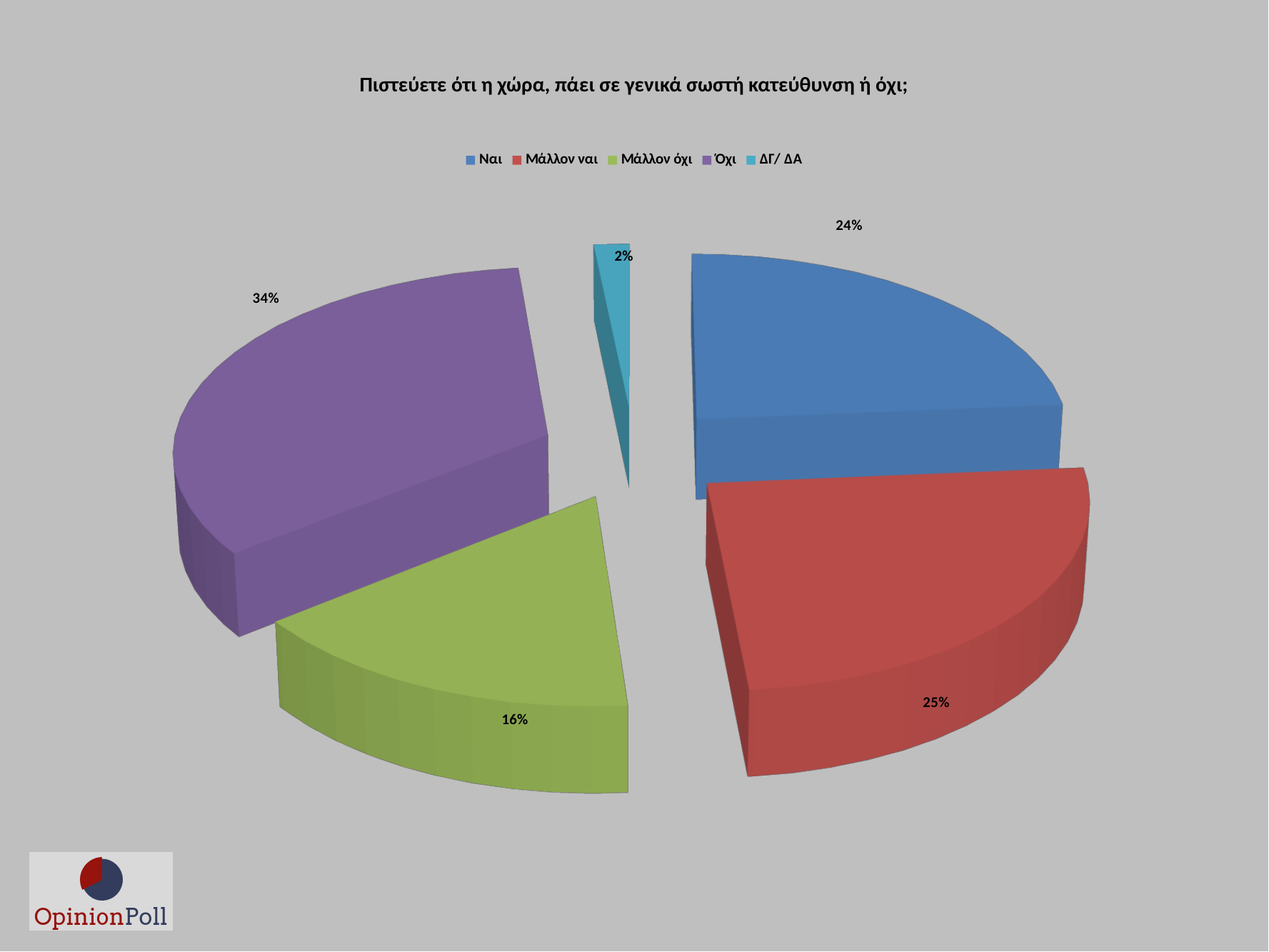
What percentage of the pie is labelled for Ναι? 24% What percentage is shown for Μάλλον ναι? 25% Which is larger, the share for Μάλλον όχι or the share for Ναι? Ναι What is the difference in percentage points between Όχι and Ναι? 10 Which category has the smallest share of the pie? ΔΓ/ ΔΑ What kind of chart is shown on the slide? Pie chart What percentage is shown for Μάλλον όχι? 16% How many categories does the pie chart show? 5 What percentage is shown for Όχι? 34% What colour is the slice for Όχι? Purple What percentage is shown for ΔΓ/ ΔΑ? 2% Which category has the largest share of the pie? Όχι